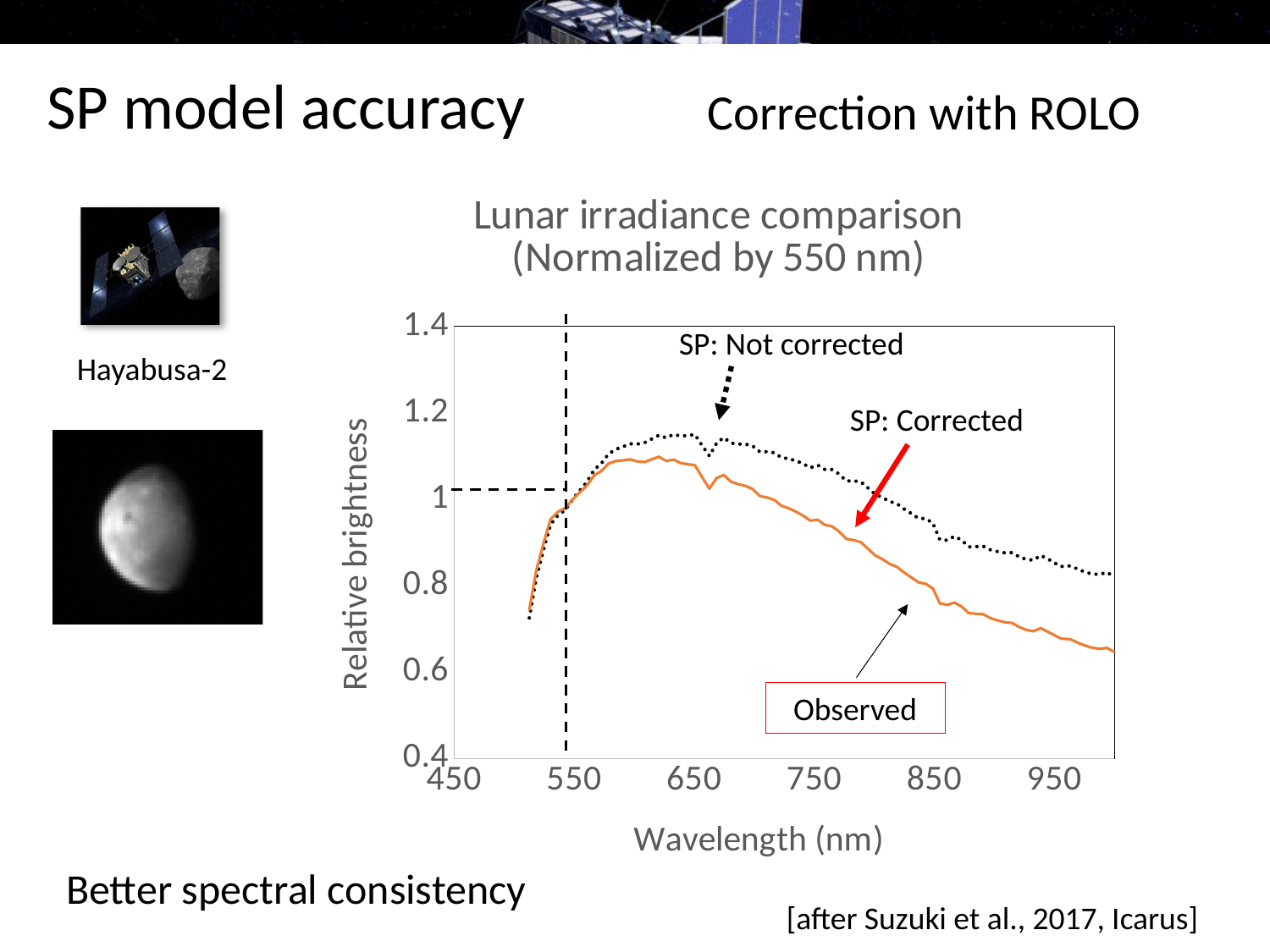
What kind of chart is shown on the slide? line chart Is the relative brightness of the SP: Corrected series at 950 nm greater or less than 0.8? less Does the relative brightness of the SP: Not corrected series rise or fall between 550 nm and 650 nm? rise At 950 nm, which series has the higher relative brightness, SP: Not corrected or SP: Corrected? SP: Not corrected What is the title of the chart? Lunar irradiance comparison (Normalized by 550 nm) Is the relative brightness of the SP: Corrected series at 850 nm greater or less than 1? less Is the relative brightness of the SP: Not corrected series at 650 nm greater or less than 1? greater Which series is drawn as a dotted black line? SP: Not corrected What is the label of the x axis of the chart? Wavelength (nm) How many data series are plotted on the chart? 2 Does the relative brightness of the SP: Corrected series rise or fall between 650 nm and 950 nm? fall